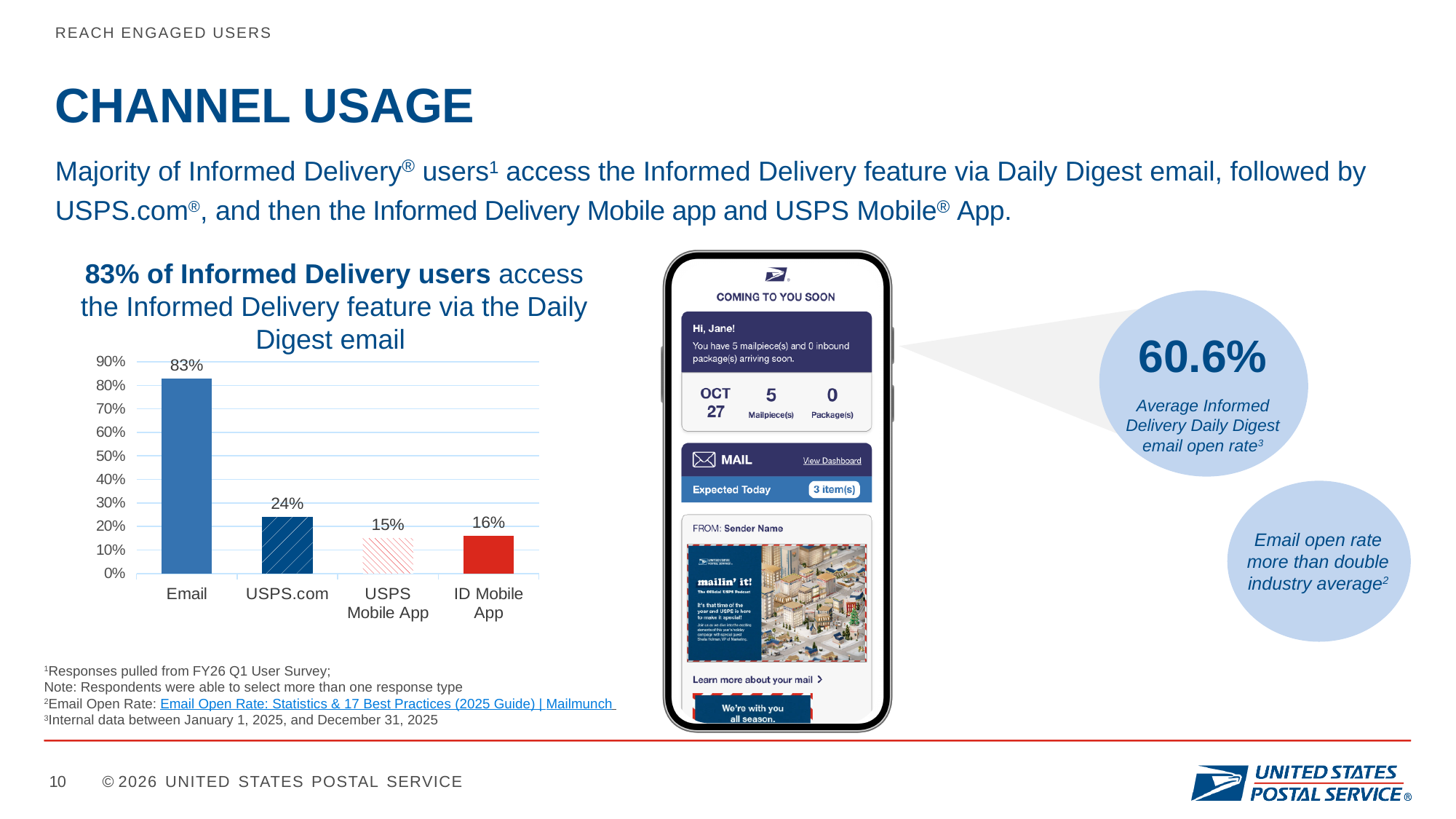
What is the difference between the Email value and the USPS.com value? 59% What is the value shown for USPS.com in the bar chart? 24% What is the value shown for the ID Mobile App? 16% Which channel has the highest value in the bar chart? Email What is the value shown for the USPS Mobile App? 15% How many channels are shown in the bar chart? 4 Is the value for USPS.com greater or less than 30%? less What kind of chart is used to show channel usage? bar chart Which channel has the lowest value in the bar chart? USPS Mobile App What is the highest value shown on the chart's vertical axis? 90% What percentage of Informed Delivery users access the feature via Email? 83% Which is larger, the value for USPS.com or the value for the ID Mobile App? USPS.com